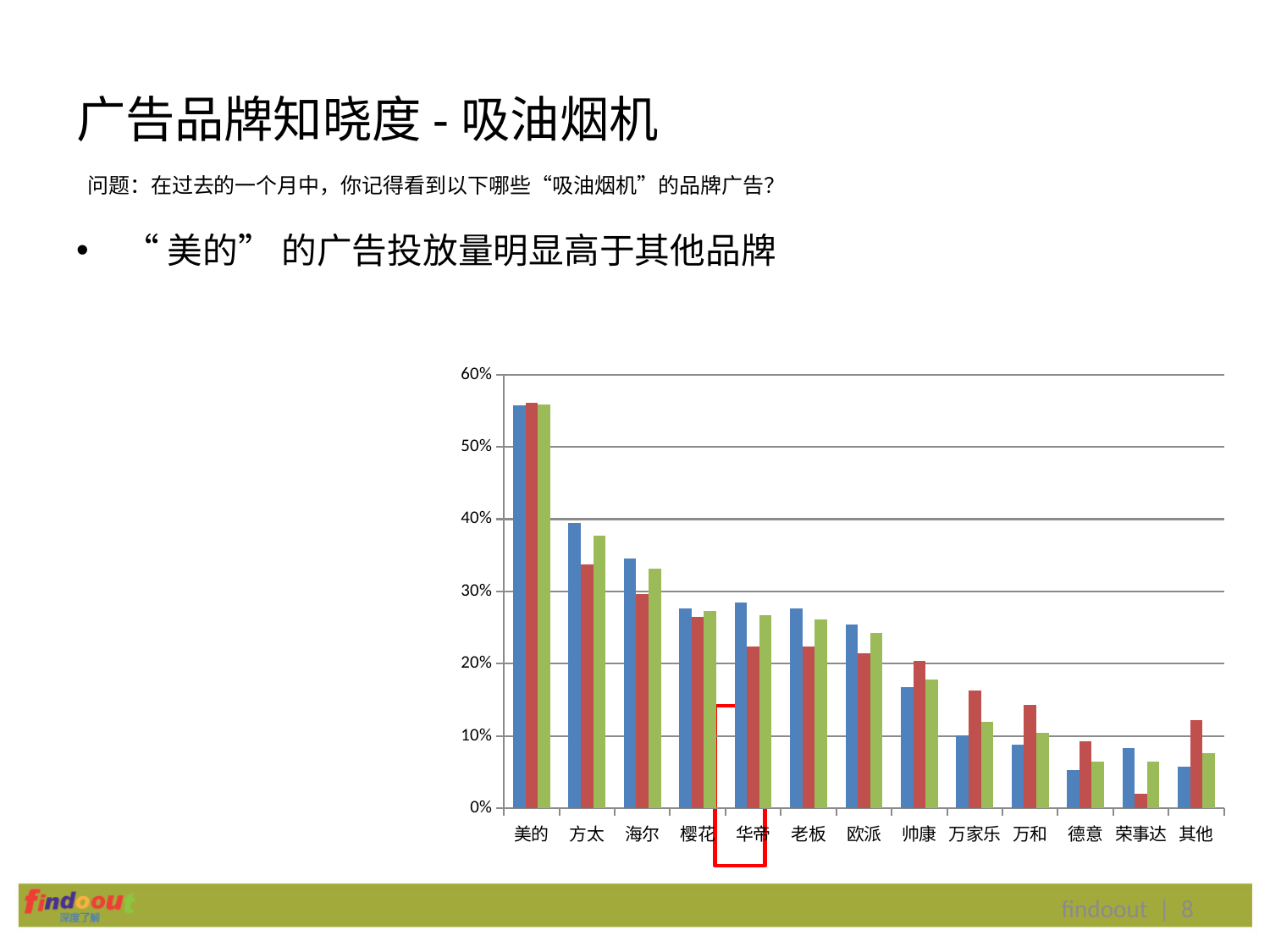
How many categories are shown on the x axis of the chart? 13 Is the blue bar for 海尔 greater or less than 30%? greater Which is larger, the blue bar for 美的 or the blue bar for 方太? 美的 Which category has the highest bars in the chart? 美的 What kind of chart is shown on the slide? bar chart Is the blue bar for 美的 greater or less than 50%? greater Is the red bar for 荣事达 greater or less than 10%? less Do the bar values generally rise or fall from 美的 to 荣事达 along the x axis? fall Which is larger for 其他, the red bar or the blue bar? the red bar Which category on the x axis is highlighted with a red box? 华帝